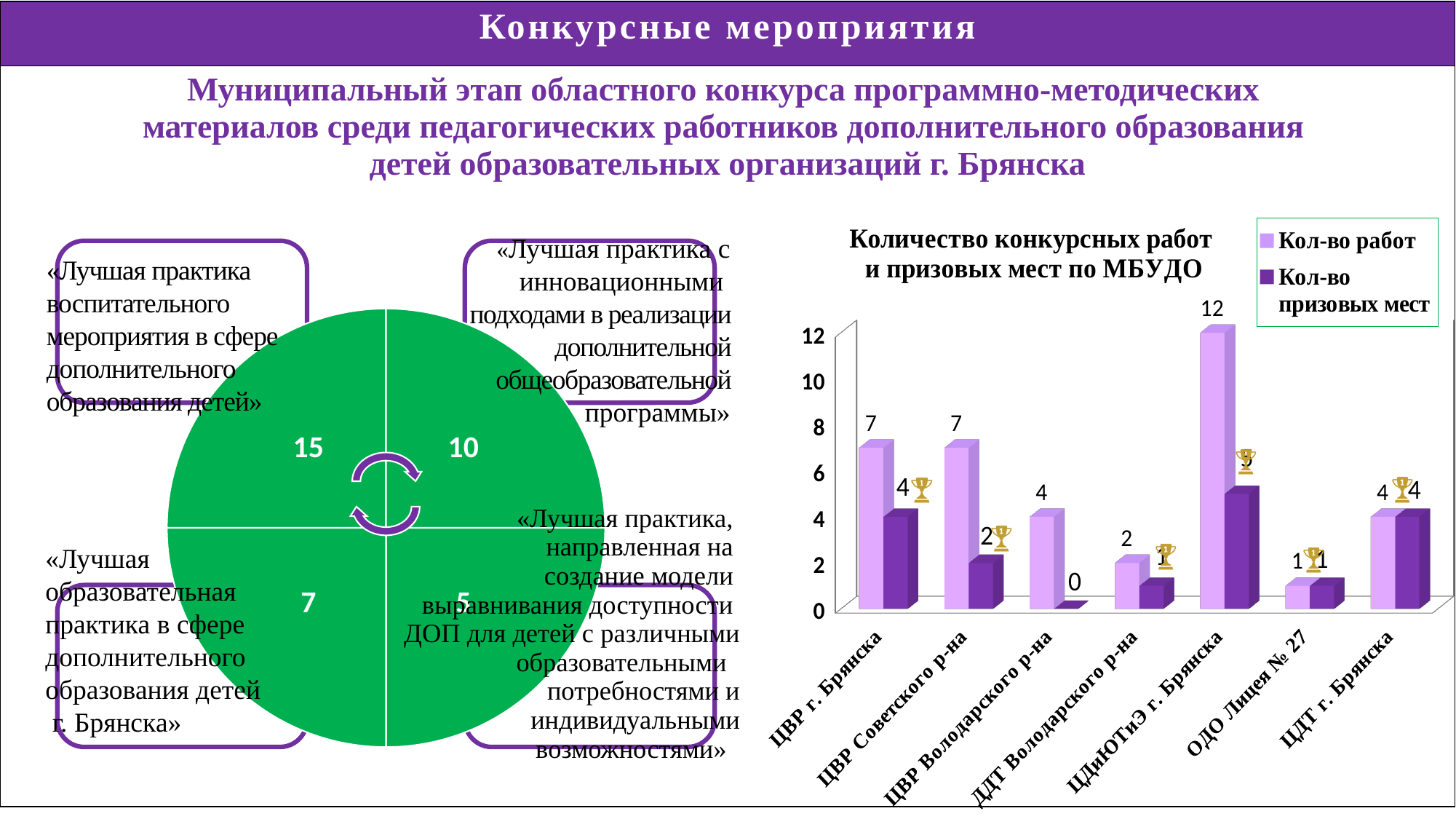
How many organisations (categories) are shown on the x axis of the bar chart? 7 Is the value of "Кол-во работ" for ЦДиЮТиЭ г. Брянска greater or less than 10? greater Which organisation has the lowest value of "Кол-во работ"? ОДО Лицея № 27 What are the two legend entries of the bar chart? Кол-во работ; Кол-во призовых мест What is the value of "Кол-во призовых мест" for ЦВР г. Брянска? 4 Which organisation has the highest value of "Кол-во работ"? ЦДиЮТиЭ г. Брянска What is the value of "Кол-во работ" for ЦВР г. Брянска? 7 What is the difference between "Кол-во работ" and "Кол-во призовых мест" for ЦВР Советского р-на? 5 Which has the larger value of "Кол-во работ": ЦВР Володарского р-на or ДДТ Володарского р-на? ЦВР Володарского р-на How many series does the legend of the chart "Количество конкурсных работ и призовых мест по МБУДО" list? 2 What is the value of "Кол-во призовых мест" for ЦВР Володарского р-на? 0 What kind of chart is shown on the right side of the slide? bar chart